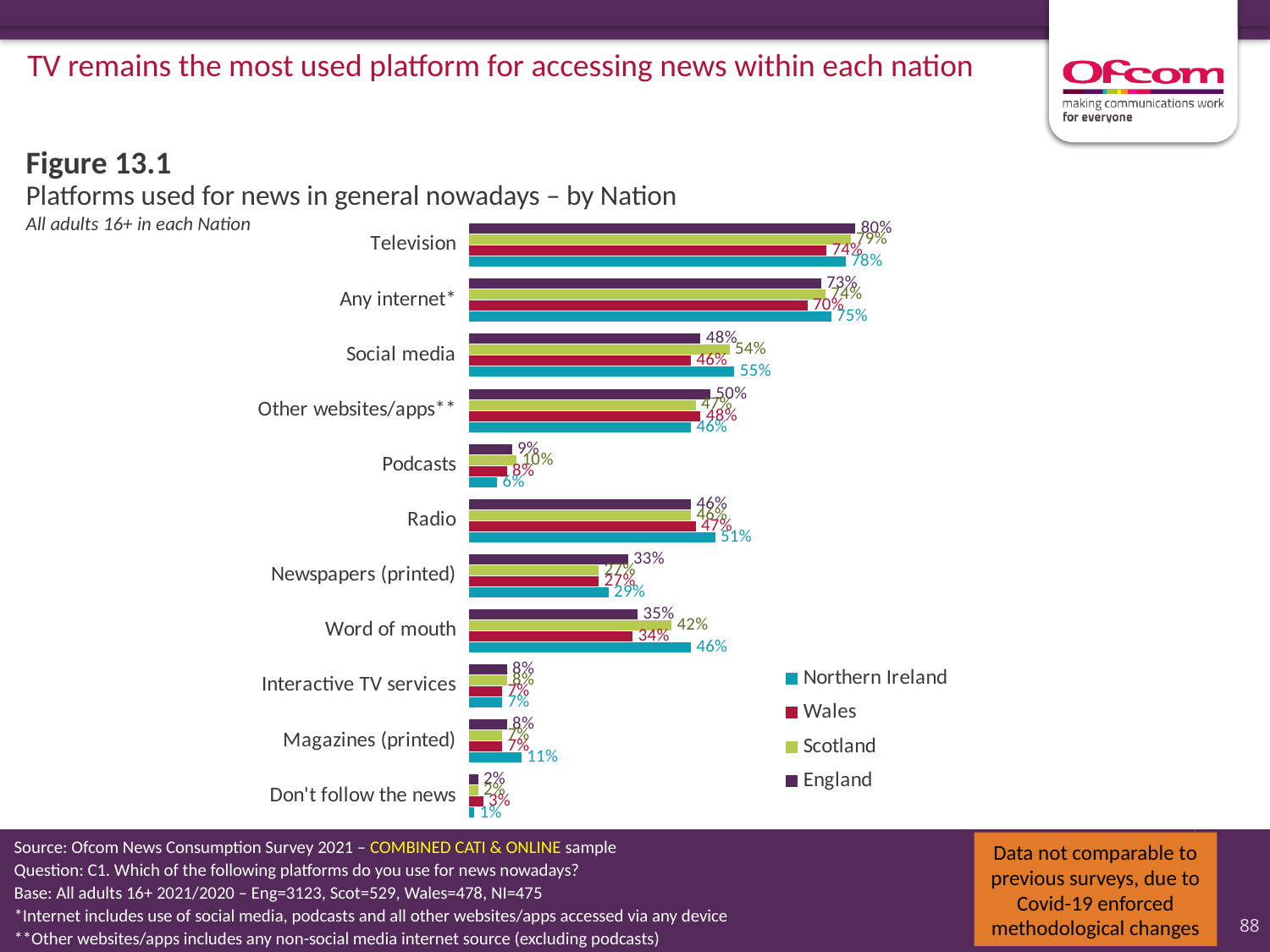
Which nation has the highest value for Television? England What kind of chart is shown on the slide? Bar chart What percentage of adults in Northern Ireland use social media for news? 55% Which colour represents Northern Ireland in the chart? Teal What percentage of adults in England use television for news? 80% What is the difference between the Northern Ireland and Wales values for Social media? 9% How many platform categories are shown on the chart? 11 What percentage of adults in Northern Ireland use printed magazines for news? 11% Which nation has the lowest value for Word of mouth? Wales How many series does the legend list? 4 For Word of mouth, which is larger: the value for Northern Ireland or the value for England? Northern Ireland What percentage of adults in Scotland use word of mouth for news? 42%